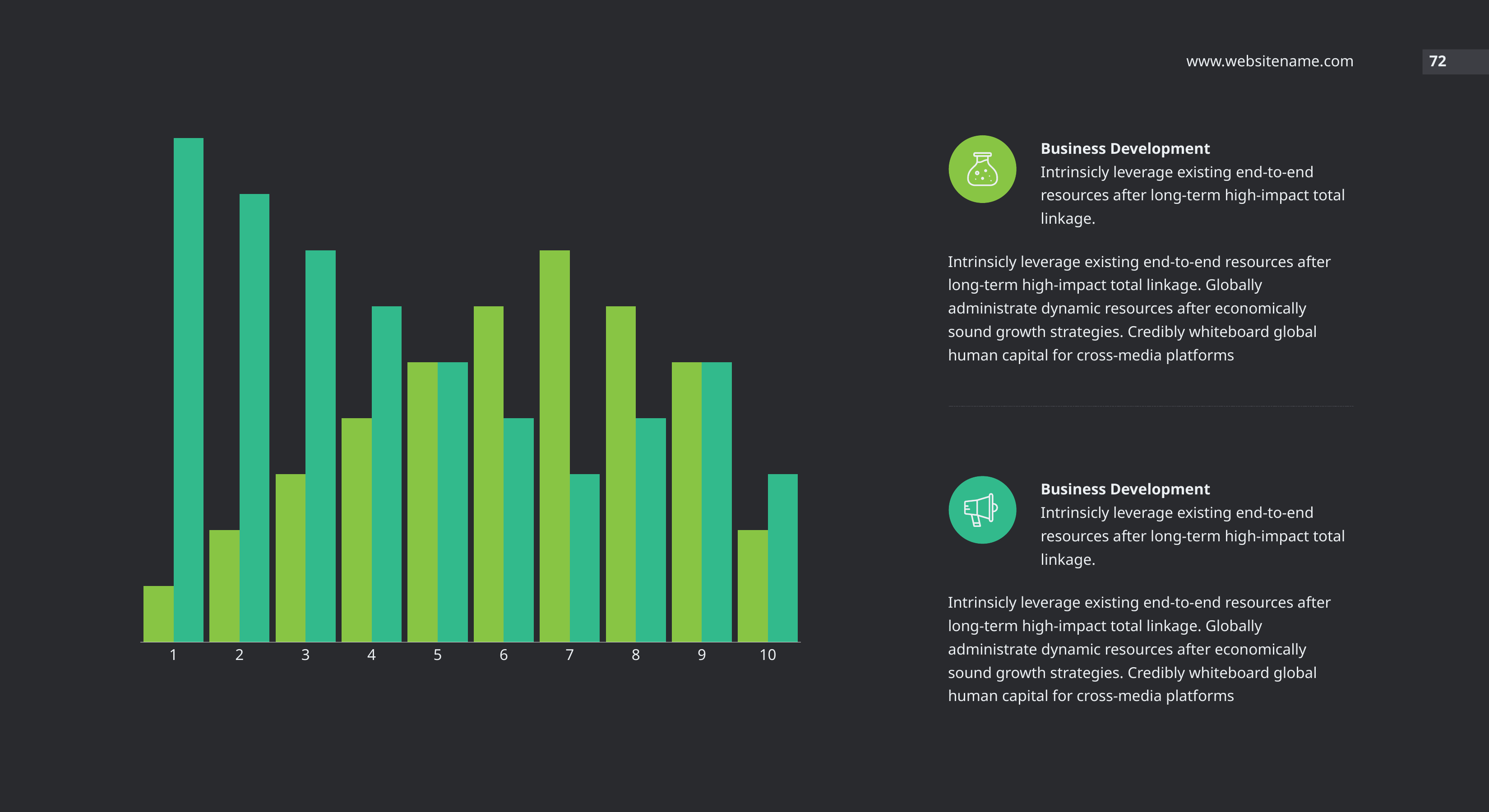
Do the light green bars rise or fall from category 1 to category 3? rise How many bars are plotted for each category on the bar chart? 2 Which category has the shortest light green bar? 1 How many categories are shown on the x axis of the bar chart? 10 What kind of chart is shown on the slide? bar chart At category 1, which bar is taller, the light green bar or the teal bar? teal Which teal bar is taller, category 2 or category 8? 2 Do the teal bars rise or fall from category 1 to category 4? fall Which light green bar is taller, category 2 or category 3? 3 Which category has the tallest light green bar? 7 Which category has the tallest teal (darker green) bar? 1